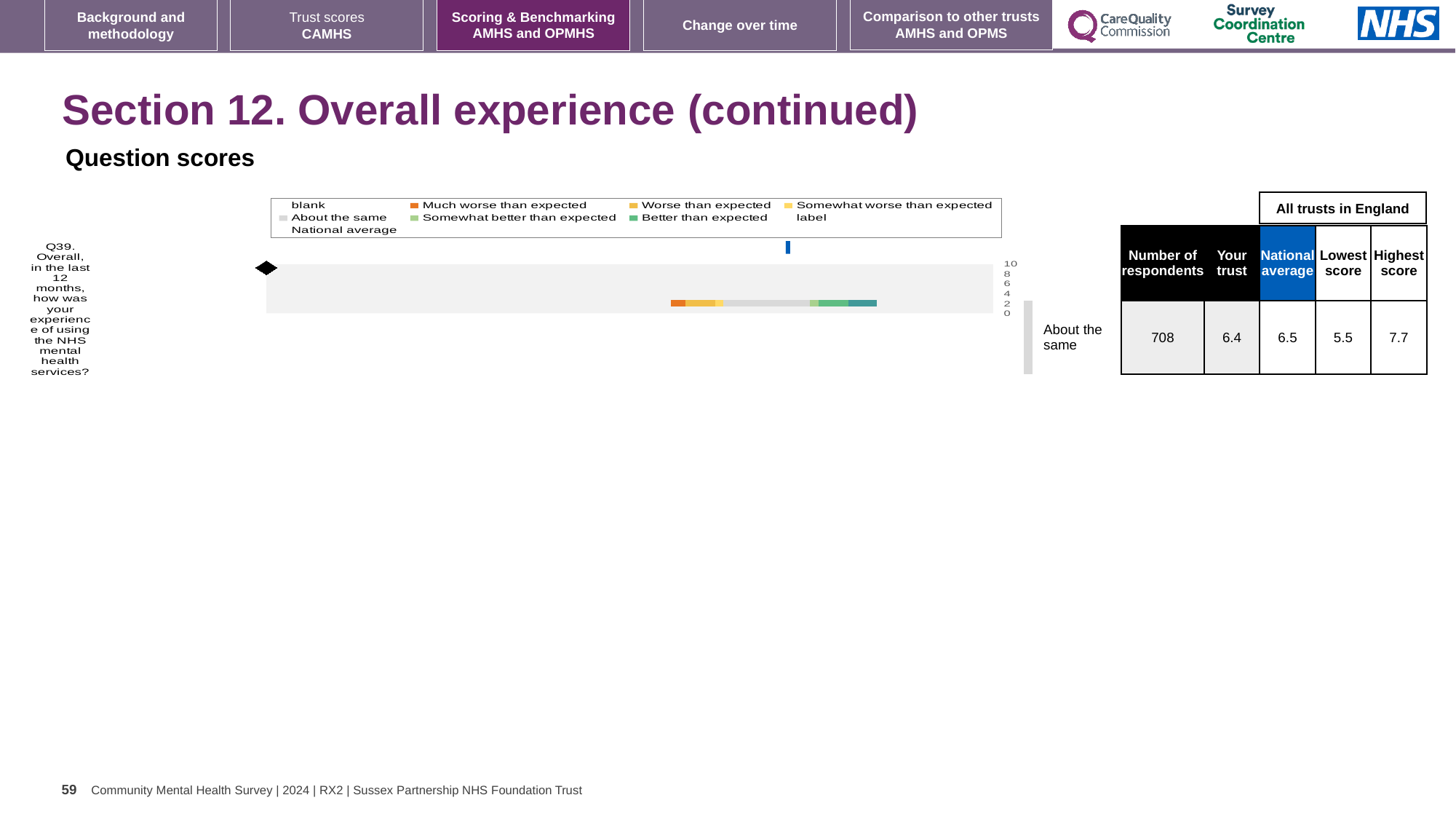
What is the maximum value shown on the chart's score axis? 10 What is the lowest score among all trusts in England for Q39? 5.5 Which benchmarking category is the trust's Q39 score placed in? About the same What is the national average score for Q39? 6.5 What is the 'Your trust' score for Q39? 6.4 Which is larger for Q39, the 'Your trust' score or the national average? National average What is the difference between the highest score and the lowest score for Q39? 2.2 How many entries does the chart legend list? 9 How many respondents answered Q39? 708 What kind of chart is used to show the Q39 benchmarking result? bar chart How many questions are plotted on the chart? 1 What is the highest score among all trusts in England for Q39? 7.7